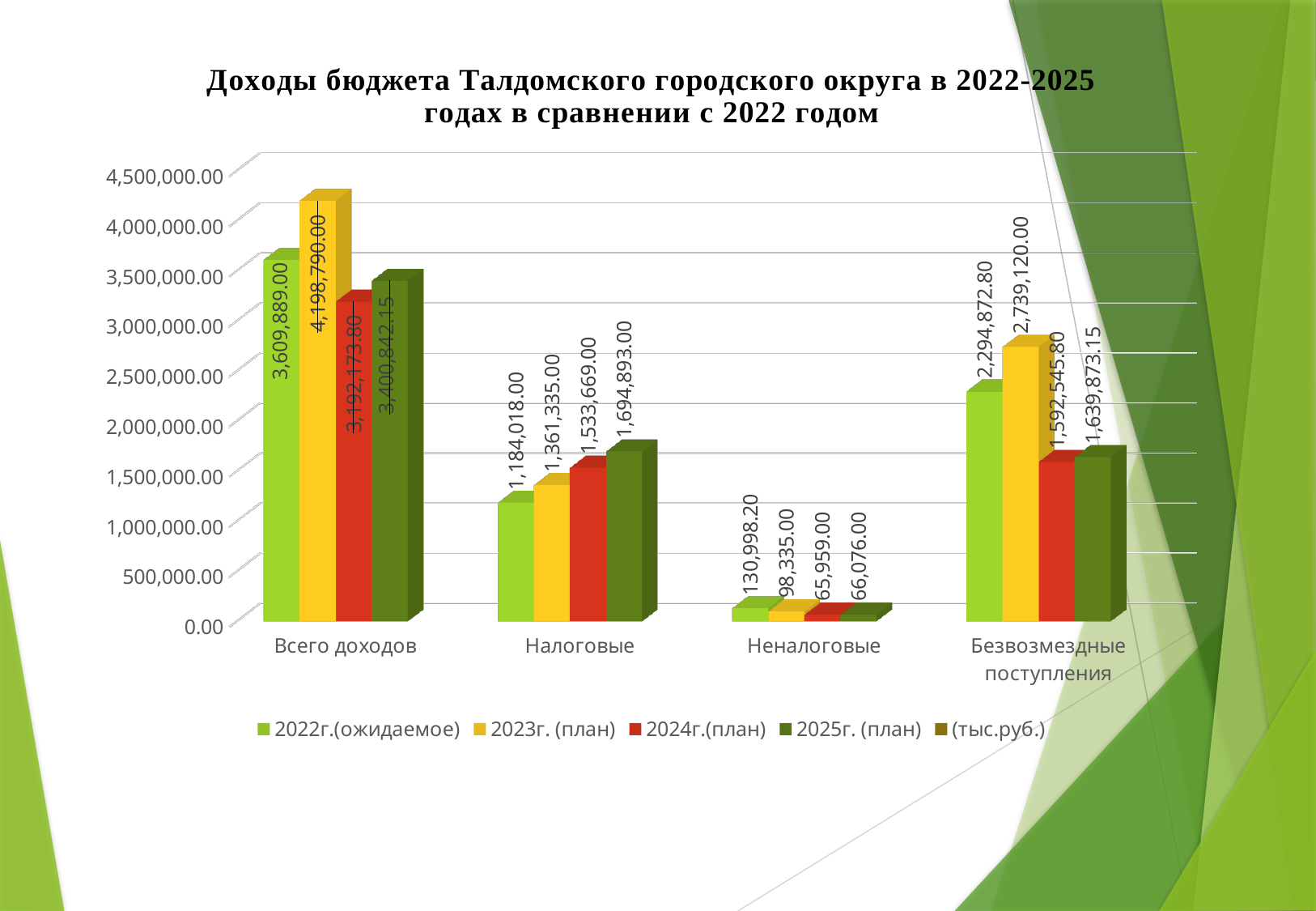
Do the values in the Налоговые category rise or fall from 2022г.(ожидаемое) to 2025г. (план)? rise What is the value for 2022г.(ожидаемое) in the Неналоговые category? 130,998.20 In the Безвозмездные поступления category, which is larger: 2022г.(ожидаемое) or 2023г. (план)? 2023г. (план) What is the value for 2025г. (план) in the Налоговые category? 1,694,893.00 Which category has the lowest value for 2022г.(ожидаемое)? Неналоговые How many categories are shown on the x axis? 4 What kind of chart is shown on the slide? bar chart What is the value for 2024г.(план) in the Безвозмездные поступления category? 1,592,545.80 What is the difference between the 2025г. (план) and 2022г.(ожидаемое) values in the Налоговые category? 510,875.00 What is the value for 2023г. (план) in the Всего доходов category? 4,198,790.00 How many entries does the legend list? 5 Which series has the highest value in the Всего доходов category? 2023г. (план)